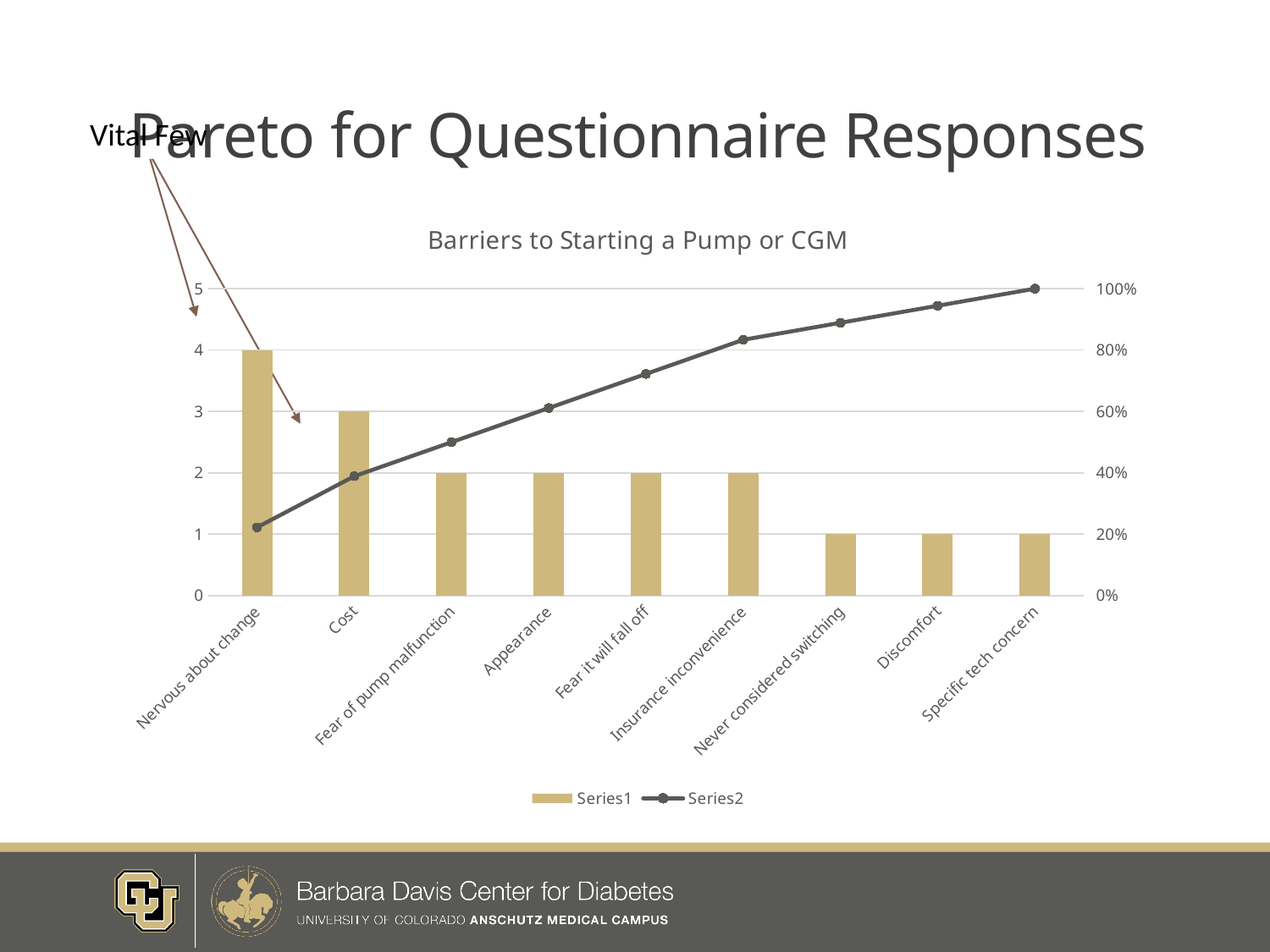
How many categories are shown on the x axis? 9 What is the Series1 value for Nervous about change? 4 What is the Series2 value at Specific tech concern? 100% What is the difference between the Series1 values for Nervous about change and Cost? 1 How many series does the legend list? 2 What kind of chart is shown on the slide? bar chart with a line Is the Series2 value at Fear of pump malfunction greater or less than 40%? greater Which category has the highest Series1 bar? Nervous about change What is the chart's title? Barriers to Starting a Pump or CGM Which has the larger Series1 value, Cost or Discomfort? Cost What is the Series1 value for Cost? 3 What is the Series1 value for Discomfort? 1